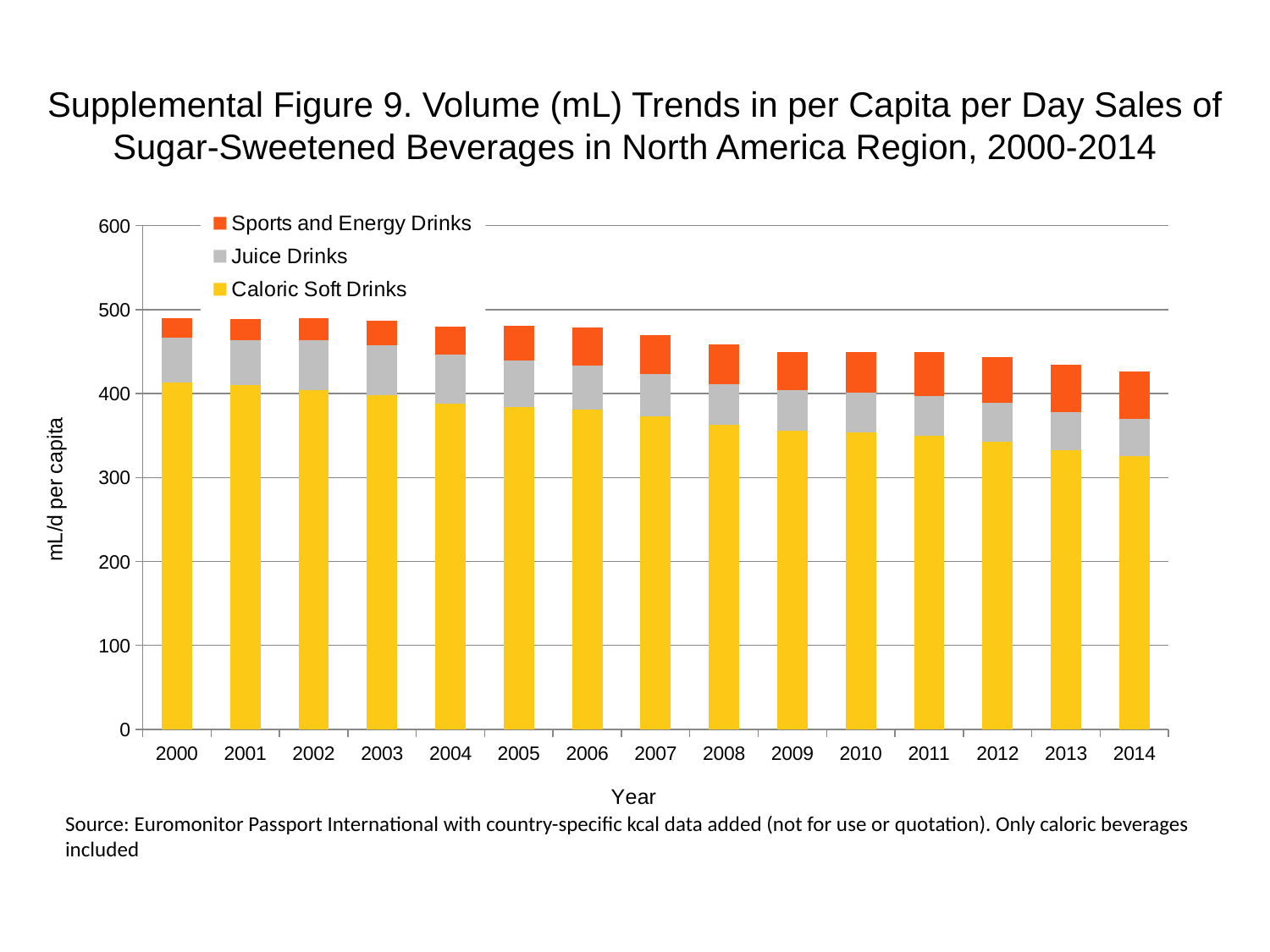
Is the value for Caloric Soft Drinks in 2014 greater or less than 350? less What kind of chart is shown on the slide? Stacked bar chart How many series does the legend list? 3 Is the total stacked bar for 2000 greater or less than 500? less Which colour represents Caloric Soft Drinks in the legend? Yellow Is the total stacked bar for 2014 greater or less than 400? greater How many years are shown along the x axis? 15 Which is larger, the total stacked bar for 2000 or for 2014? 2000 Does the Caloric Soft Drinks segment rise or fall from 2000 to 2014? Fall Does the Sports and Energy Drinks segment rise or fall from 2000 to 2014? Rise What is the label on the y axis? mL/d per capita